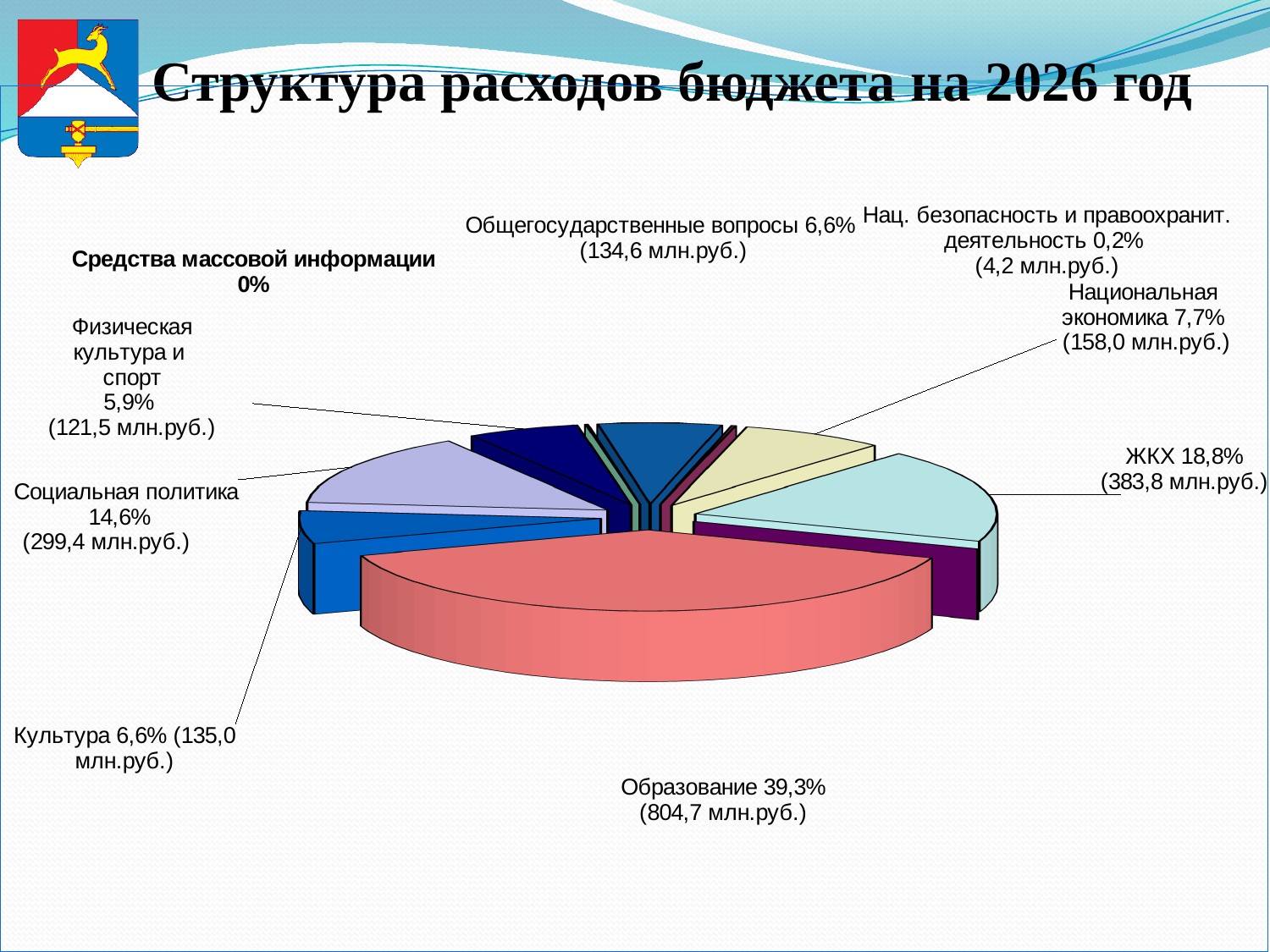
What is the amount in млн.руб. for Нац. безопасность и правоохранит. деятельность? 4,2 млн.руб. Which is larger: the share for ЖКХ or the share for Социальная политика? ЖКХ Which category has the largest share of the budget expenditure? Образование How many categories are labelled on the pie chart? 9 What share of the budget expenditure does Образование account for? 39,3% What kind of chart is shown on the slide? Pie chart What is the amount in млн.руб. for ЖКХ? 383,8 млн.руб. What is the title of the chart on the slide? Структура расходов бюджета на 2026 год What is the difference in percentage points between Образование (39,3%) and ЖКХ (18,8%)? 20,5 What percentage is shown for Социальная политика? 14,6% What is the amount in млн.руб. for Национальная экономика? 158,0 млн.руб.